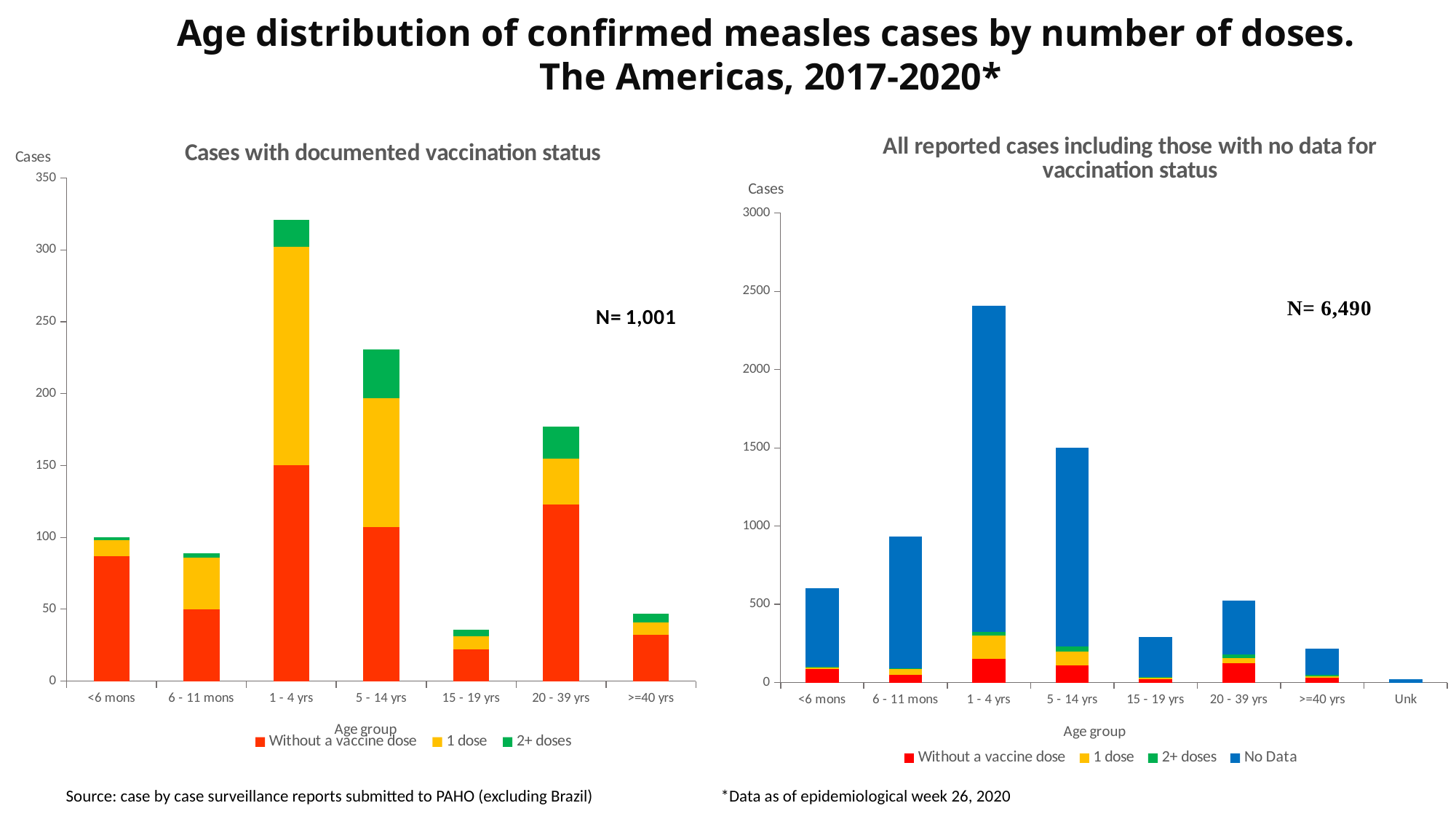
How many series does the legend list in the chart titled 'Cases with documented vaccination status'? 3 In the chart titled 'Cases with documented vaccination status', is the total for 20 - 39 yrs greater or less than 150? greater In the chart titled 'Cases with documented vaccination status', which age group has the shortest stacked bar? 15 - 19 yrs In the chart titled 'Cases with documented vaccination status', is the total for 1 - 4 yrs greater or less than 300? greater What type of chart is the chart on the right of the slide? Stacked bar chart In the chart titled 'Cases with documented vaccination status', which age group has the tallest stacked bar? 1 - 4 yrs In the chart titled 'All reported cases including those with no data for vaccination status', is the total for 15 - 19 yrs greater or less than 500? less How many series does the legend list in the chart titled 'All reported cases including those with no data for vaccination status'? 4 In the chart titled 'All reported cases including those with no data for vaccination status', which age group has the tallest bar? 1 - 4 yrs In the chart titled 'Cases with documented vaccination status', which has the larger total: 5 - 14 yrs or 20 - 39 yrs? 5 - 14 yrs How many age groups are shown in the chart titled 'Cases with documented vaccination status'? 7